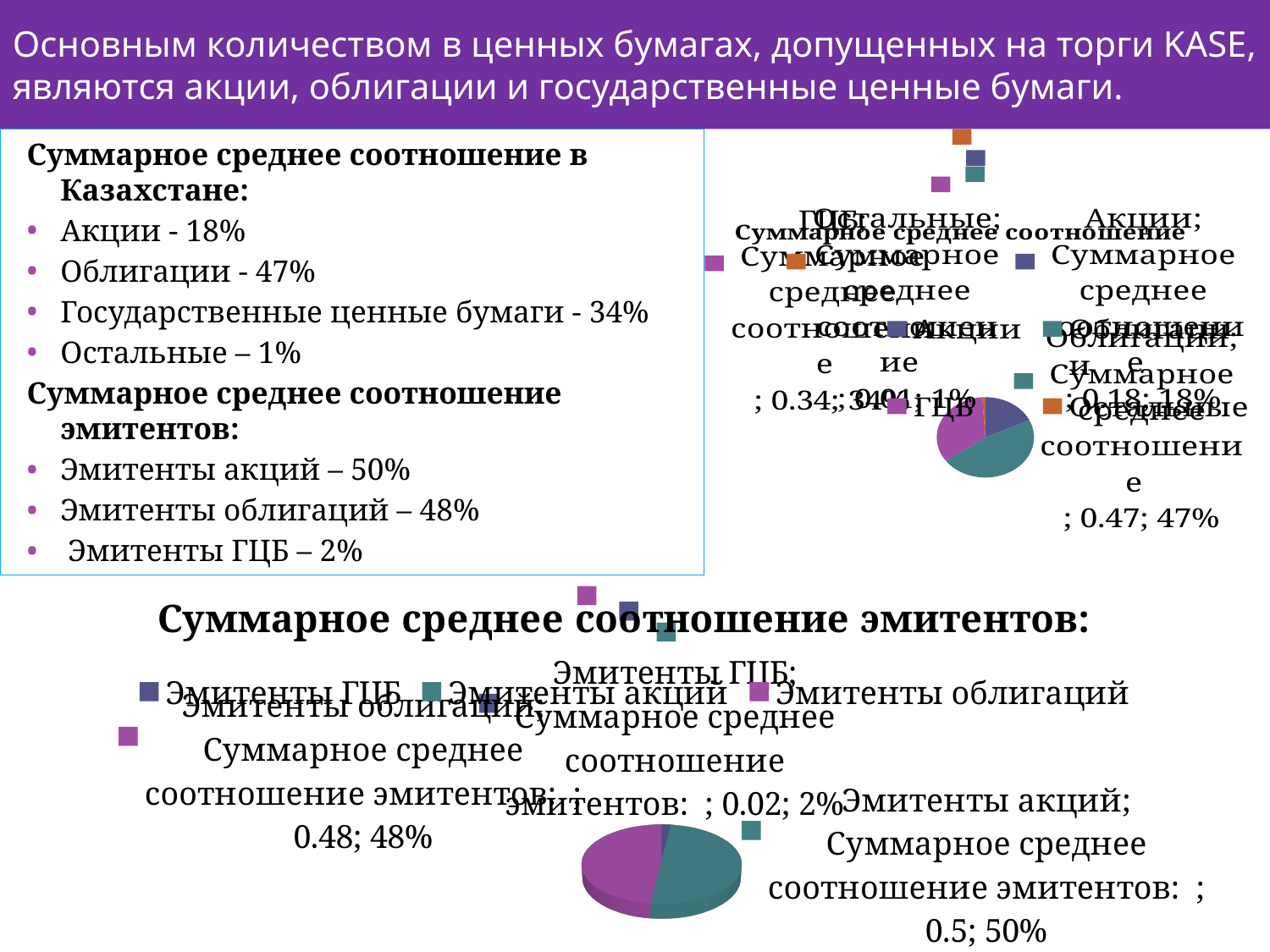
In the bottom pie chart 'Суммарное среднее соотношение эмитентов', how many categories does the legend list? 3 In the top-right pie chart 'Суммарное среднее соотношение', what share does 'Акции' have? 18% In the bottom pie chart 'Суммарное среднее соотношение эмитентов', what share does 'Эмитенты ГЦБ' have? 2% In the top-right pie chart 'Суммарное среднее соотношение', how many categories does the legend list? 4 In the top-right pie chart 'Суммарное среднее соотношение', what is the difference between the shares of 'Облигации' and 'ГЦБ'? 13% In the top-right pie chart 'Суммарное среднее соотношение', which category has the largest share? Облигации In the top-right pie chart 'Суммарное среднее соотношение', what share does 'ГЦБ' have? 34% In the bottom pie chart 'Суммарное среднее соотношение эмитентов', which is larger: 'Эмитенты акций' or 'Эмитенты облигаций'? Эмитенты акций In the top-right pie chart 'Суммарное среднее соотношение', which category has the smallest share? Остальные What type of chart is the top-right chart titled 'Суммарное среднее соотношение'? pie chart